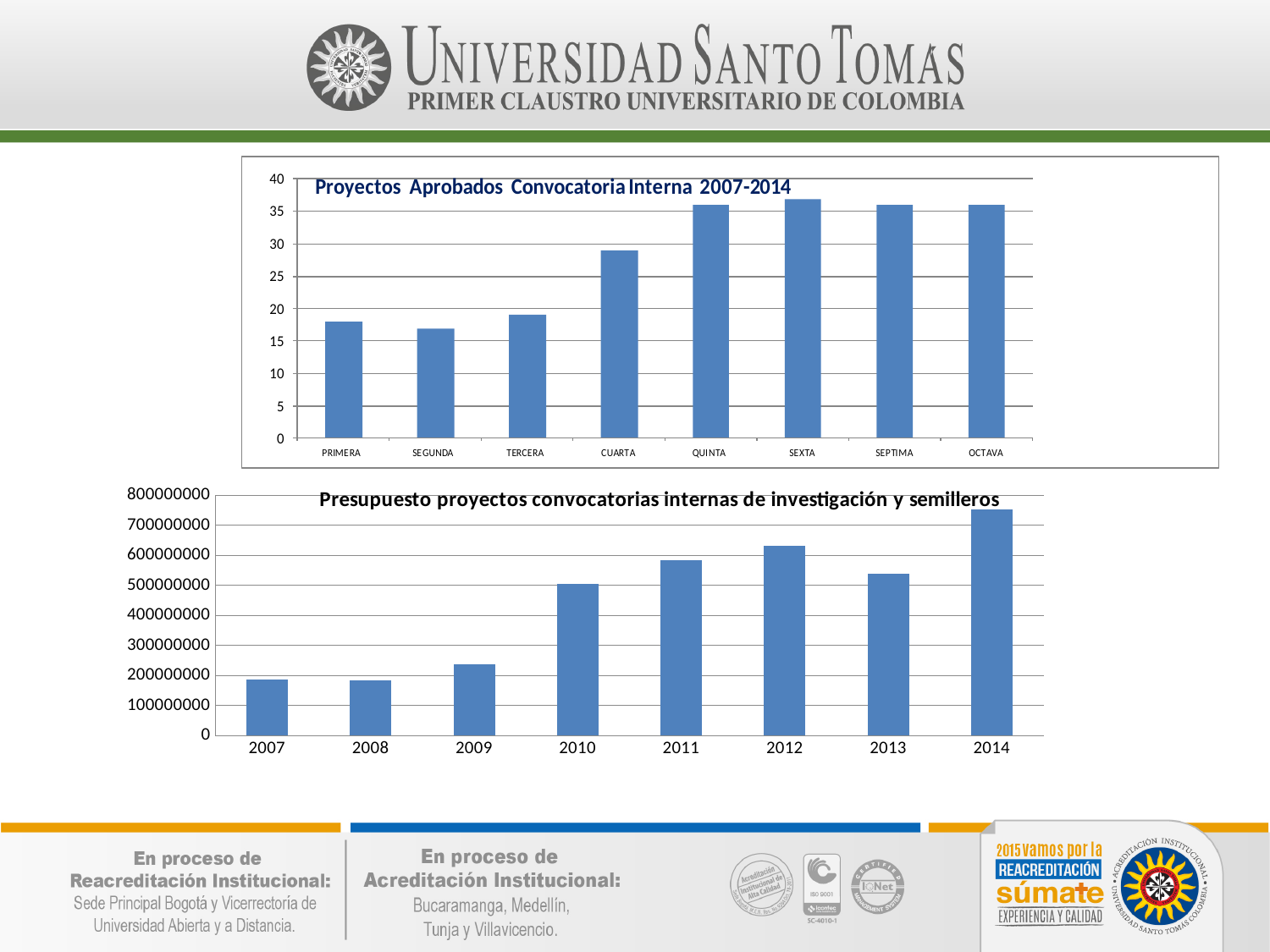
In the top chart 'Proyectos Aprobados Convocatoria Interna 2007-2014', is the value for PRIMERA greater or less than 20? less In the chart titled 'Proyectos Aprobados Convocatoria Interna 2007-2014', how many categories are shown on the x axis? 8 In the bottom chart 'Presupuesto proyectos convocatorias internas de investigación y semilleros', do the values rise or fall from 2009 to 2012? rise In the bottom chart 'Presupuesto proyectos convocatorias internas de investigación y semilleros', is the value for 2009 greater or less than 300000000? less In the bottom chart 'Presupuesto proyectos convocatorias internas de investigación y semilleros', which year has the highest value? 2014 In the top chart 'Proyectos Aprobados Convocatoria Interna 2007-2014', is the value for CUARTA greater or less than 25? greater In the bottom chart 'Presupuesto proyectos convocatorias internas de investigación y semilleros', which is larger, the value for 2012 or the value for 2013? 2012 What kind of chart is the top chart, 'Proyectos Aprobados Convocatoria Interna 2007-2014'? bar chart In the bottom chart 'Presupuesto proyectos convocatorias internas de investigación y semilleros', how many years are shown on the x axis? 8 In the top chart 'Proyectos Aprobados Convocatoria Interna 2007-2014', which is larger, the value for TERCERA or the value for CUARTA? CUARTA